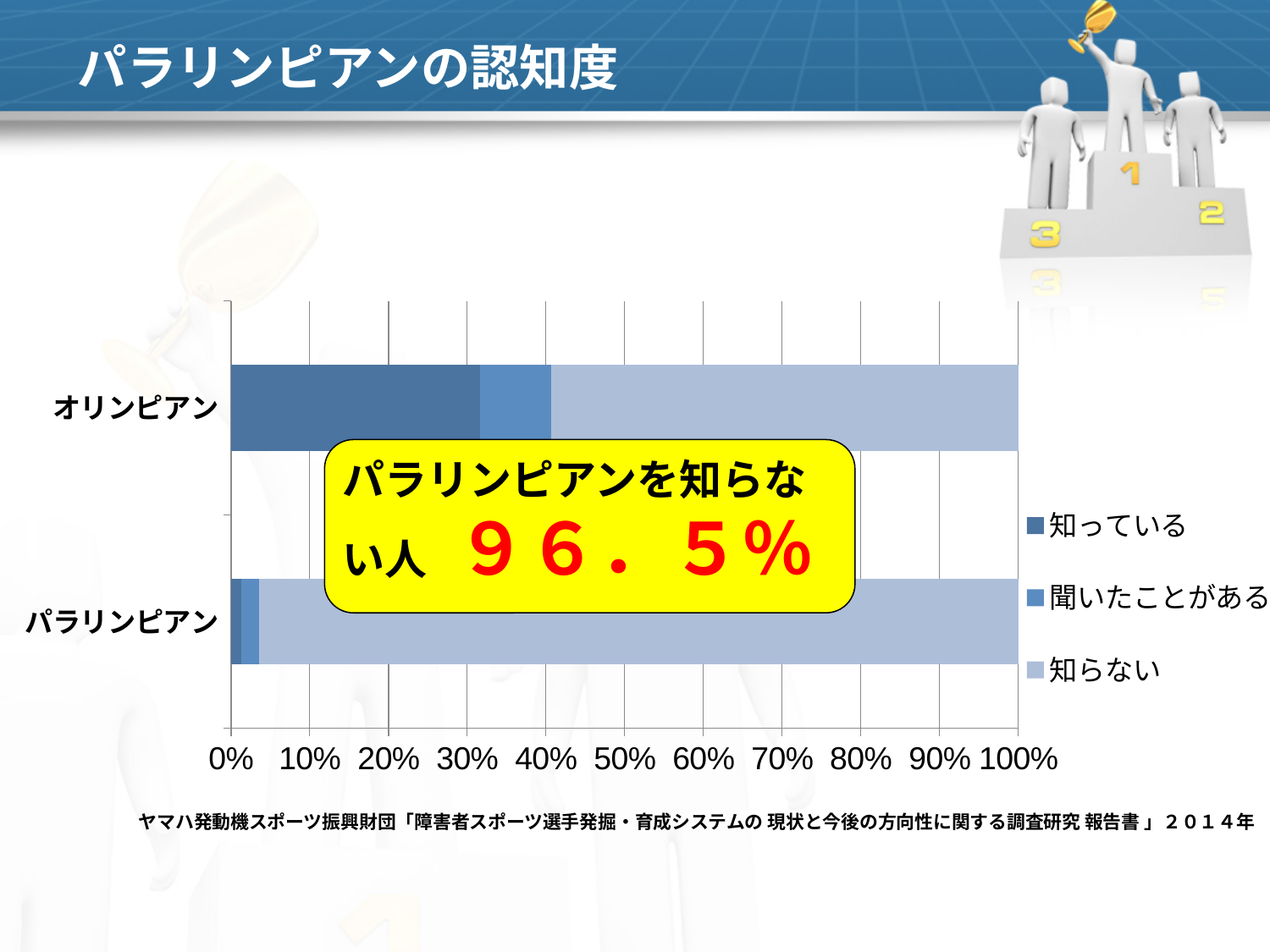
What is the highest value shown on the x axis of the chart? 100% Is the 知っている value for パラリンピアン greater or less than 10%? less Is the 知っている value for オリンピアン greater or less than 40%? less How many categories are plotted on the chart? 2 How many series does the legend list? 3 What are the three legend entries of the chart? 知っている, 聞いたことがある, 知らない According to the callout on the chart, what share of people do not know Paralympians (パラリンピアンを知らない人)? 96.5% Which category has the larger 知らない share, オリンピアン or パラリンピアン? パラリンピアン What kind of chart is shown on the slide? stacked bar chart What is the title of the slide containing the chart? パラリンピアンの認知度 Is the 知っている value for オリンピアン greater or less than 20%? greater Which category has the larger 知っている share, オリンピアン or パラリンピアン? オリンピアン